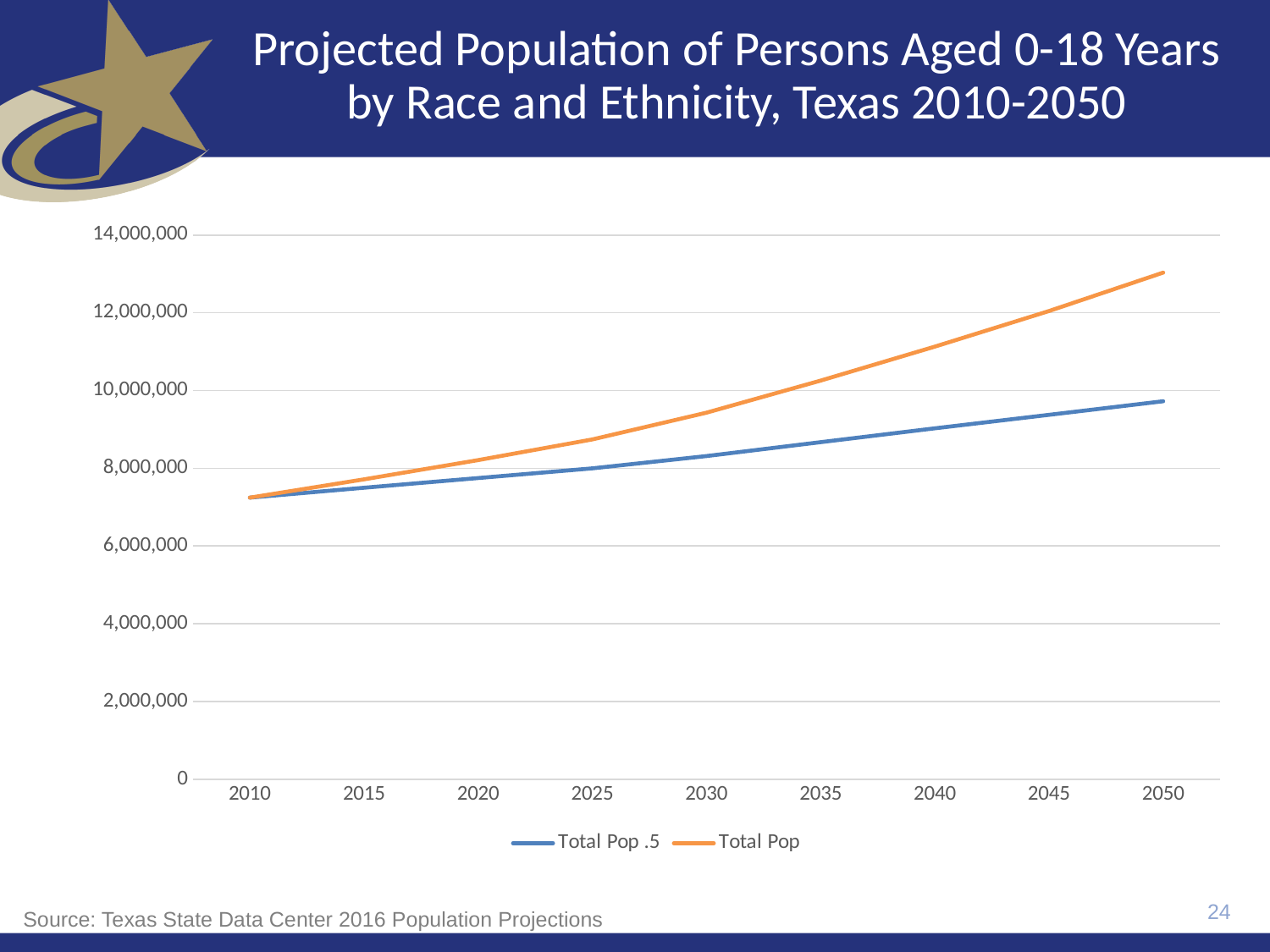
Which series is shown in orange? Total Pop In 2050, which series has the larger value, Total Pop or Total Pop .5? Total Pop Is the value for Total Pop in 2040 greater or less than 10,000,000? greater Is the value for Total Pop in 2010 greater or less than 8,000,000? less How many series does the legend list? 2 Does the Total Pop series rise or fall from 2010 to 2050? rise How many years are marked along the x axis? 9 Does the Total Pop .5 series rise or fall from 2010 to 2050? rise Is the value for Total Pop in 2050 greater or less than 12,000,000? greater What kind of chart is shown on the slide? line chart What is the title of the chart? Projected Population of Persons Aged 0-18 Years by Race and Ethnicity, Texas 2010-2050